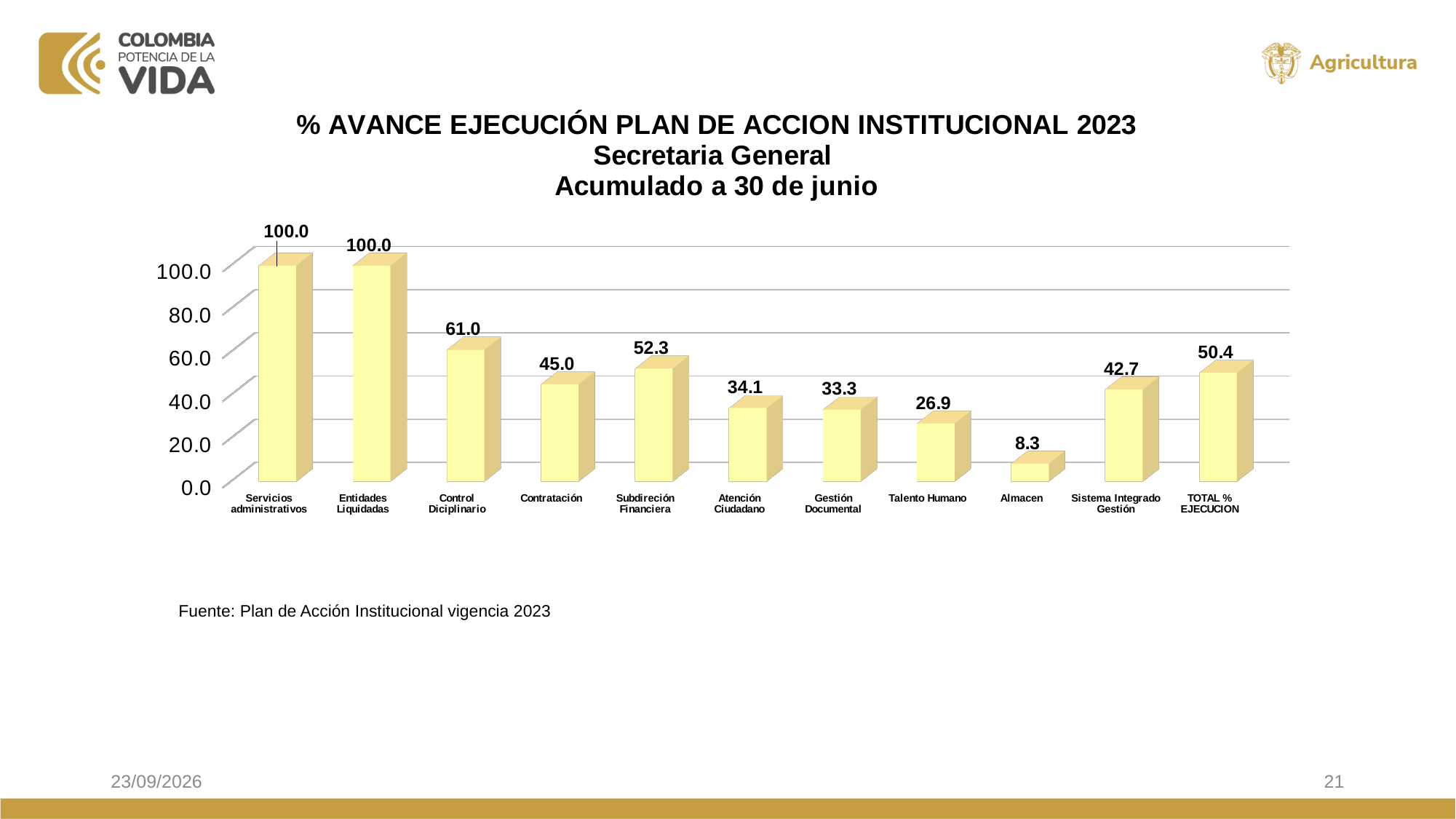
What is the value for Sistema Integrado Gestión? 42.7 What is the difference between the values for Subdirección Financiera and Contratación? 7.3 Which category has the lowest value? Almacen What kind of chart is shown on the slide? bar chart What is the difference between the values for Control Diciplinario and Talento Humano? 34.1 Which is larger, the value for Atención Ciudadano or the value for Gestión Documental? Atención Ciudadano Is the value for Talento Humano greater or less than 40.0? less What is the value for Almacen? 8.3 What is the value for TOTAL % EJECUCION? 50.4 How many categories are shown on the x axis? 11 What is the source cited below the chart? Plan de Acción Institucional vigencia 2023 What is the value for Control Diciplinario? 61.0